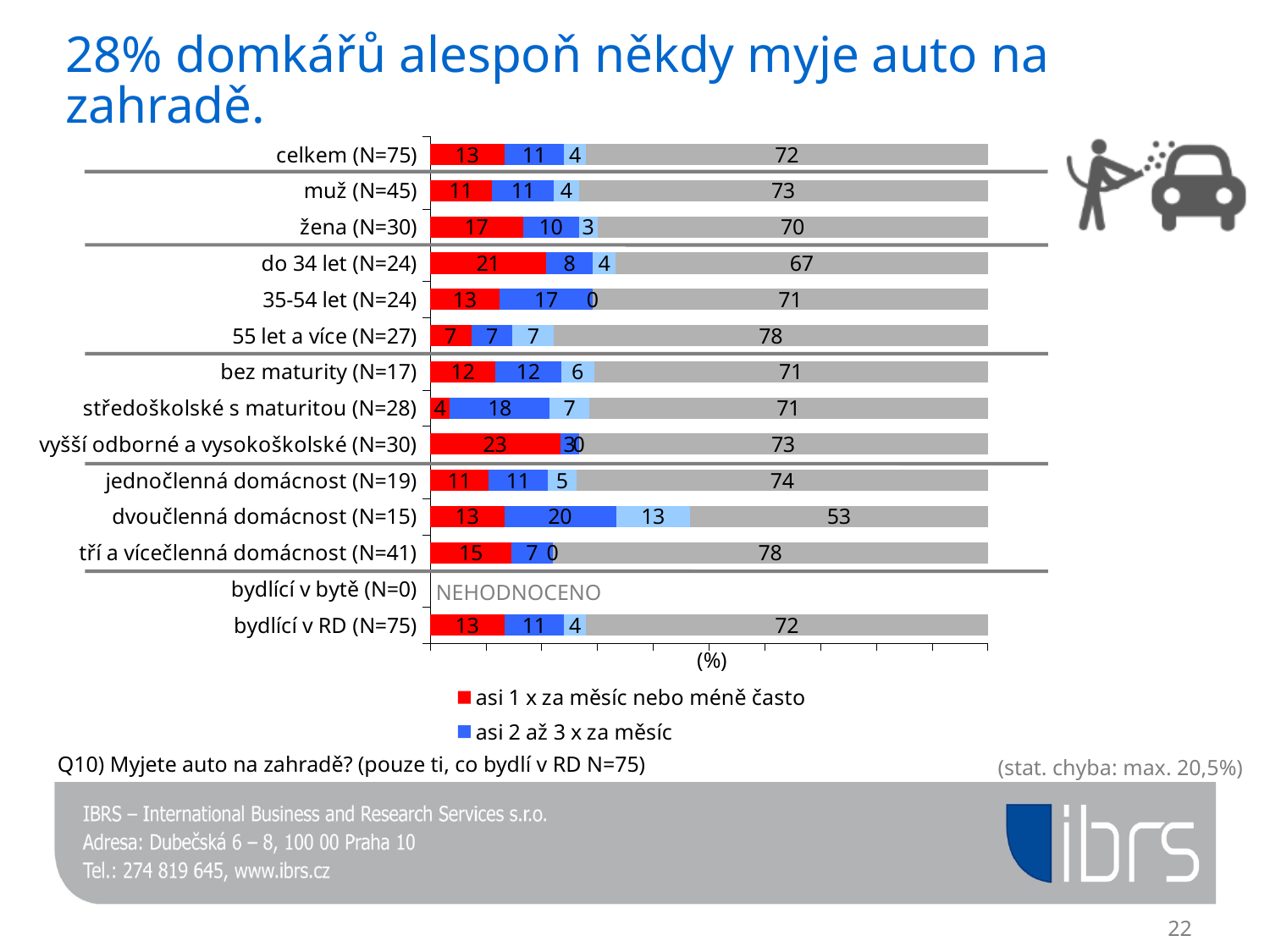
What is the value of the gray segment for '55 let a více (N=27)'? 78 Which category has the highest value for the red segment (asi 1 x za měsíc nebo méně často)? vyšší odborné a vysokoškolské (N=30) What is the total of the stacked bar for 'celkem (N=75)'? 100 What is the value of the red segment (asi 1 x za měsíc nebo méně často) for 'celkem (N=75)'? 13 How many categories are listed on the vertical axis of the chart? 14 What kind of chart is shown on the slide? bar chart Which category has the lowest value for the red segment (asi 1 x za měsíc nebo méně často)? středoškolské s maturitou (N=28) What text is shown in place of a bar for 'bydlící v bytě (N=0)'? NEHODNOCENO Which category has the lowest value for the gray segment? dvoučlenná domácnost (N=15) What is the difference between the red segment values for 'do 34 let (N=24)' and '55 let a více (N=27)'? 14 What is the value of the blue segment (asi 2 až 3 x za měsíc) for 'dvoučlenná domácnost (N=15)'? 20 Which has a larger blue segment (asi 2 až 3 x za měsíc): '35-54 let (N=24)' or 'do 34 let (N=24)'? 35-54 let (N=24)